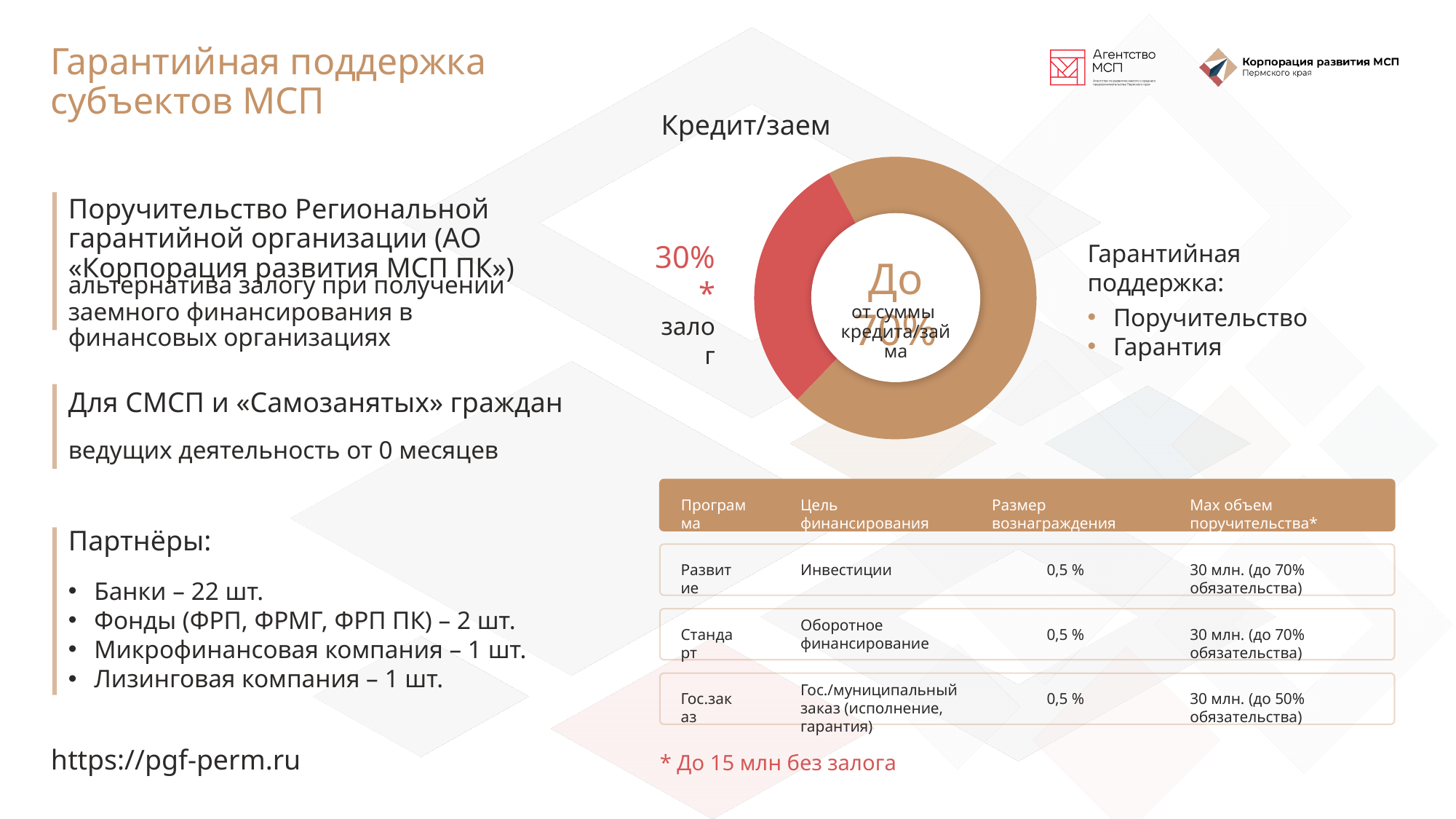
What share of the loan amount does the larger slice of the «Кредит/заем» chart represent? До 70% What kind of chart is shown under the heading «Кредит/заем»? Donut (pie) chart Which slice of the «Кредит/заем» chart is the smallest? залог (30%) Which slice of the «Кредит/заем» chart is larger: the «залог» slice or the guarantee-support slice? The guarantee-support slice (70%) What colour is the «залог» (30%) slice in the «Кредит/заем» chart? Red What share of the «Кредит/заем» chart is labelled «залог»? 30% Is the «залог» share in the «Кредит/заем» chart greater or less than 50%? less By how many percentage points does the 70% slice exceed the 30% «залог» slice in the «Кредит/заем» chart? 40 percentage points How many slices does the «Кредит/заем» donut chart have? 2 What is the title of the chart on the slide? Кредит/заем